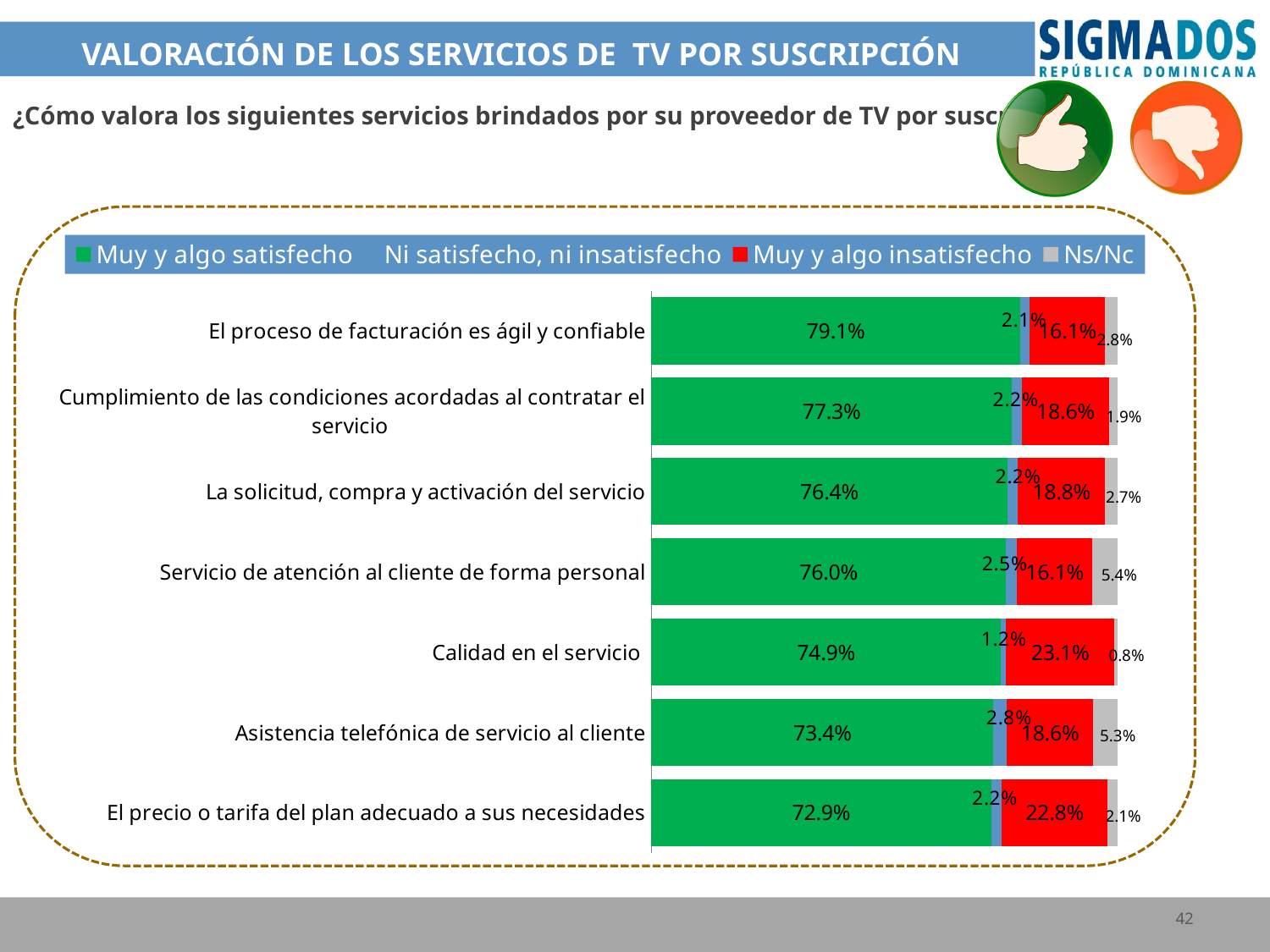
How many series does the legend list? 4 How many service categories are plotted in the chart? 7 What type of chart is shown on the slide? Stacked bar chart Which category has the highest 'Muy y algo insatisfecho' value? Calidad en el servicio Which category has the highest 'Muy y algo satisfecho' value? El proceso de facturación es ágil y confiable What is the 'Ns/Nc' value for 'Servicio de atención al cliente de forma personal'? 5.4% What is the 'Muy y algo satisfecho' value for 'Calidad en el servicio'? 74.9% What is the 'Muy y algo insatisfecho' value for 'El precio o tarifa del plan adecuado a sus necesidades'? 22.8% Which category has the lowest 'Muy y algo satisfecho' value? El precio o tarifa del plan adecuado a sus necesidades Which series is shown in red in the chart? Muy y algo insatisfecho What is the difference between the 'Muy y algo satisfecho' values for 'El proceso de facturación es ágil y confiable' and 'Asistencia telefónica de servicio al cliente'? 5.7% Which is larger: the 'Muy y algo insatisfecho' value for 'La solicitud, compra y activación del servicio' or for 'Servicio de atención al cliente de forma personal'? La solicitud, compra y activación del servicio